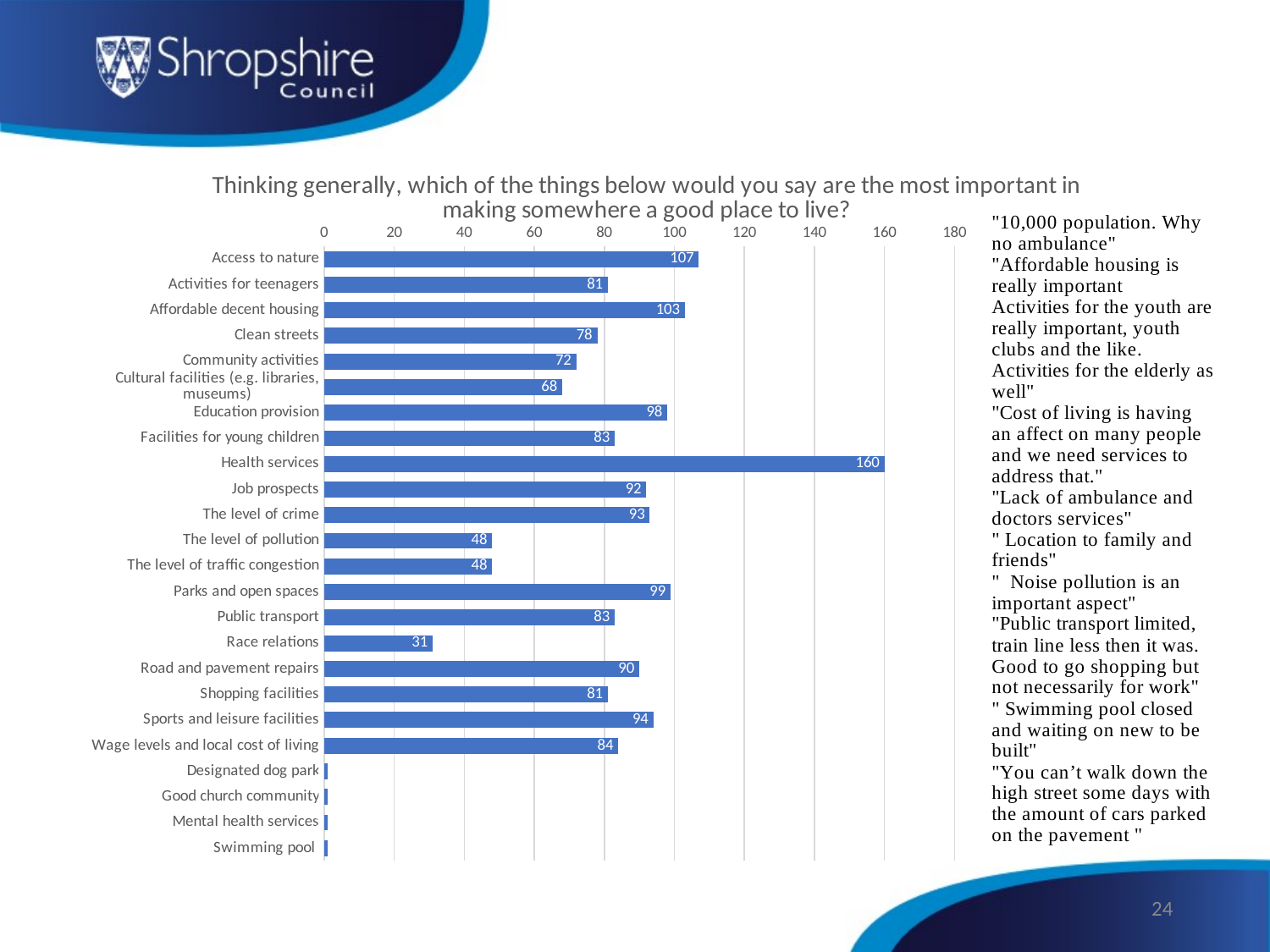
What kind of chart is shown on the slide? Bar chart What value is shown for Parks and open spaces? 99 What is the difference between the values for Health services and Affordable decent housing? 57 Which is larger, the value for Sports and leisure facilities or the value for Cultural facilities (e.g. libraries, museums)? Sports and leisure facilities What is the difference between the values for Access to nature and Clean streets? 29 What value is shown for Access to nature? 107 What is the title of the chart? Thinking generally, which of the things below would you say are the most important in making somewhere a good place to live? Which category has the highest value? Health services Which is larger, the value for Education provision or the value for Community activities? Education provision Is the value for Designated dog park greater or less than 20? less What value is shown for Health services? 160 What value is shown for Race relations? 31